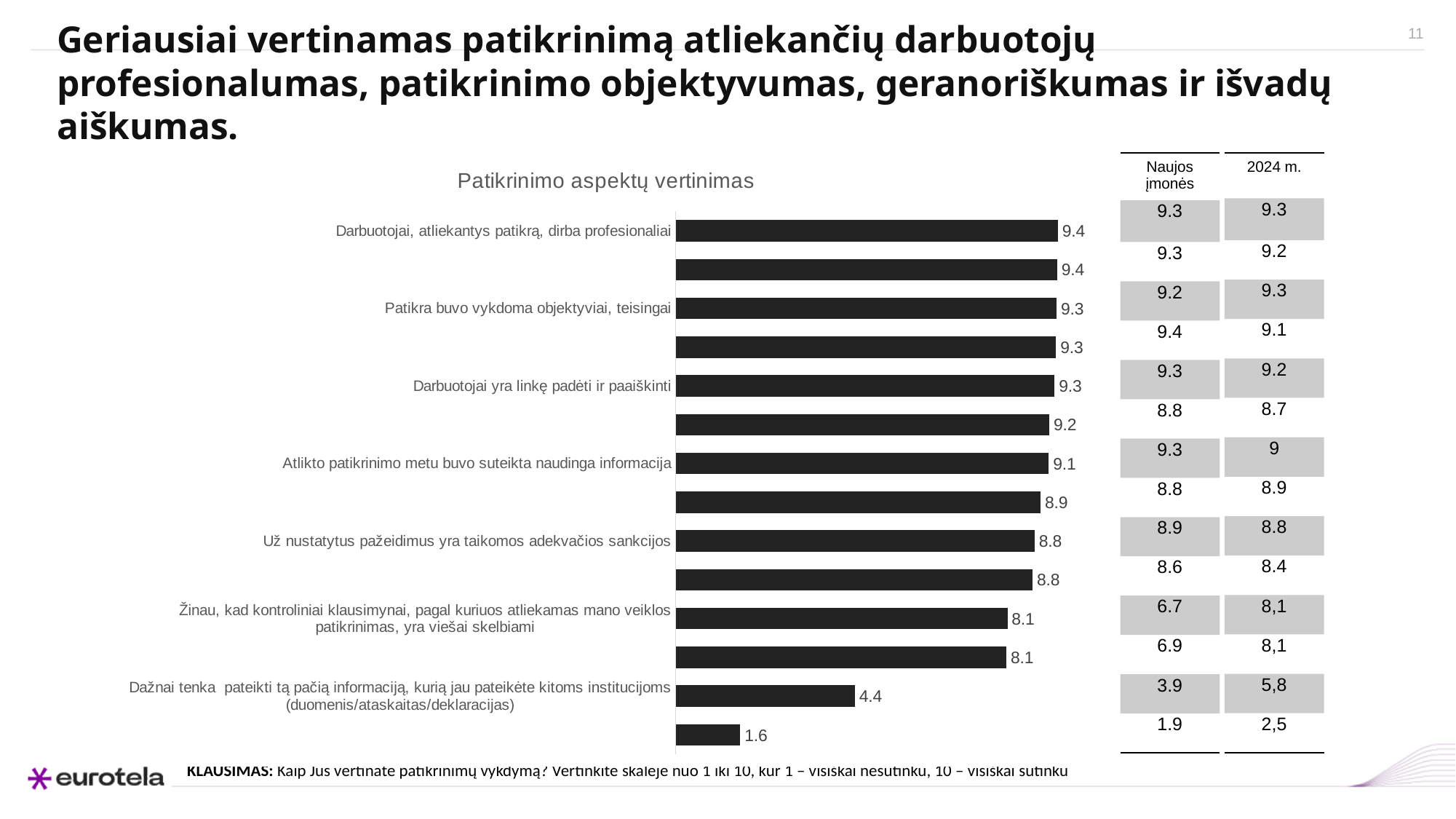
What is the value of the upper bar for "Darbuotojai, atliekantys patikrą, dirba profesionaliai"? 9.4 What is the value of the lower bar for "Darbuotojai yra linkę padėti ir paaiškinti"? 9.2 What type of chart is shown on the slide? bar chart What is the title of the chart? Patikrinimo aspektų vertinimas Which category has the lowest values in the chart? Dažnai tenka pateikti tą pačią informaciją, kurią jau pateikėte kitoms institucijoms (duomenis/ataskaitas/deklaracijas) What is the value of the upper bar for "Patikra buvo vykdoma objektyviai, teisingai"? 9.3 What is the value of the upper bar for "Atlikto patikrinimo metu buvo suteikta naudinga informacija"? 9.1 Which is larger: the upper bar for "Atlikto patikrinimo metu buvo suteikta naudinga informacija" or the upper bar for "Už nustatytus pažeidimus yra taikomos adekvačios sankcijos"? Atlikto patikrinimo metu buvo suteikta naudinga informacija How many labelled categories does the chart show? 7 Which category has the highest value in the chart? Darbuotojai, atliekantys patikrą, dirba profesionaliai What is the value of the lower bar for "Dažnai tenka pateikti tą pačią informaciją, kurią jau pateikėte kitoms institucijoms (duomenis/ataskaitas/deklaracijas)"? 1.6 What is the difference between the upper bar (4.4) and the lower bar (1.6) for "Dažnai tenka pateikti tą pačią informaciją, kurią jau pateikėte kitoms institucijoms"? 2.8